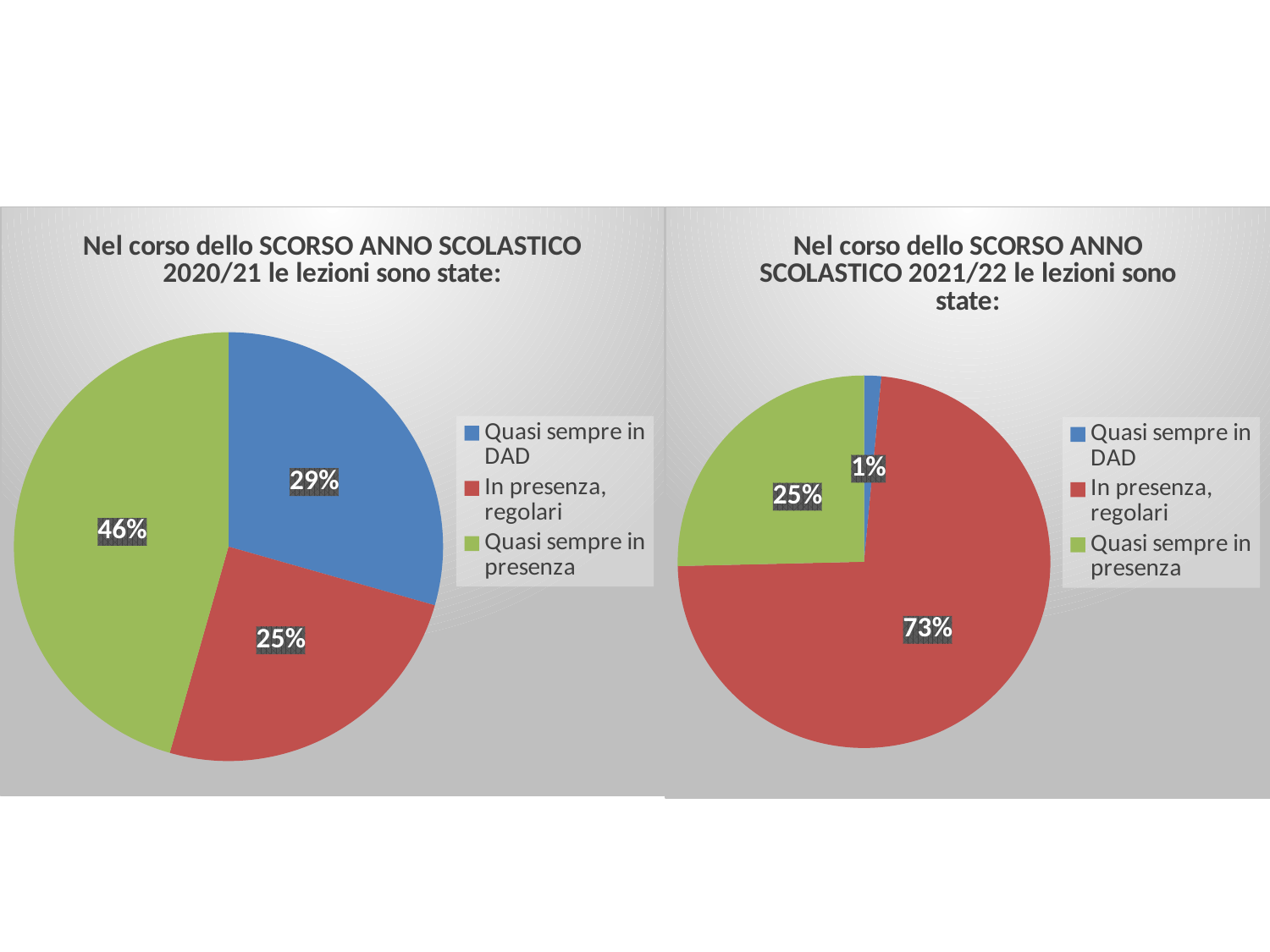
In the right pie chart (2021/22), what percentage is shown for 'Quasi sempre in DAD'? 1% In the right pie chart (2021/22), which category has the smallest share? Quasi sempre in DAD What type of chart is used on the left side of the slide? Pie chart In the right pie chart (2021/22), what percentage is shown for 'In presenza, regolari'? 73% How many slices does the right pie chart (2021/22) have? 3 In the left pie chart (2020/21), what percentage is shown for 'Quasi sempre in presenza'? 46% In the left pie chart (2020/21), which is larger: 'Quasi sempre in DAD' or 'In presenza, regolari'? Quasi sempre in DAD In the left pie chart (2020/21), what percentage is shown for 'Quasi sempre in DAD'? 29% In the left pie chart (2020/21), what is the difference in percentage points between 'Quasi sempre in presenza' and 'In presenza, regolari'? 21 In the right pie chart (2021/22), what colour represents 'In presenza, regolari'? Red In the right pie chart (2021/22), what is the difference in percentage points between 'In presenza, regolari' and 'Quasi sempre in presenza'? 48 In the left pie chart (2020/21), which category has the largest share? Quasi sempre in presenza